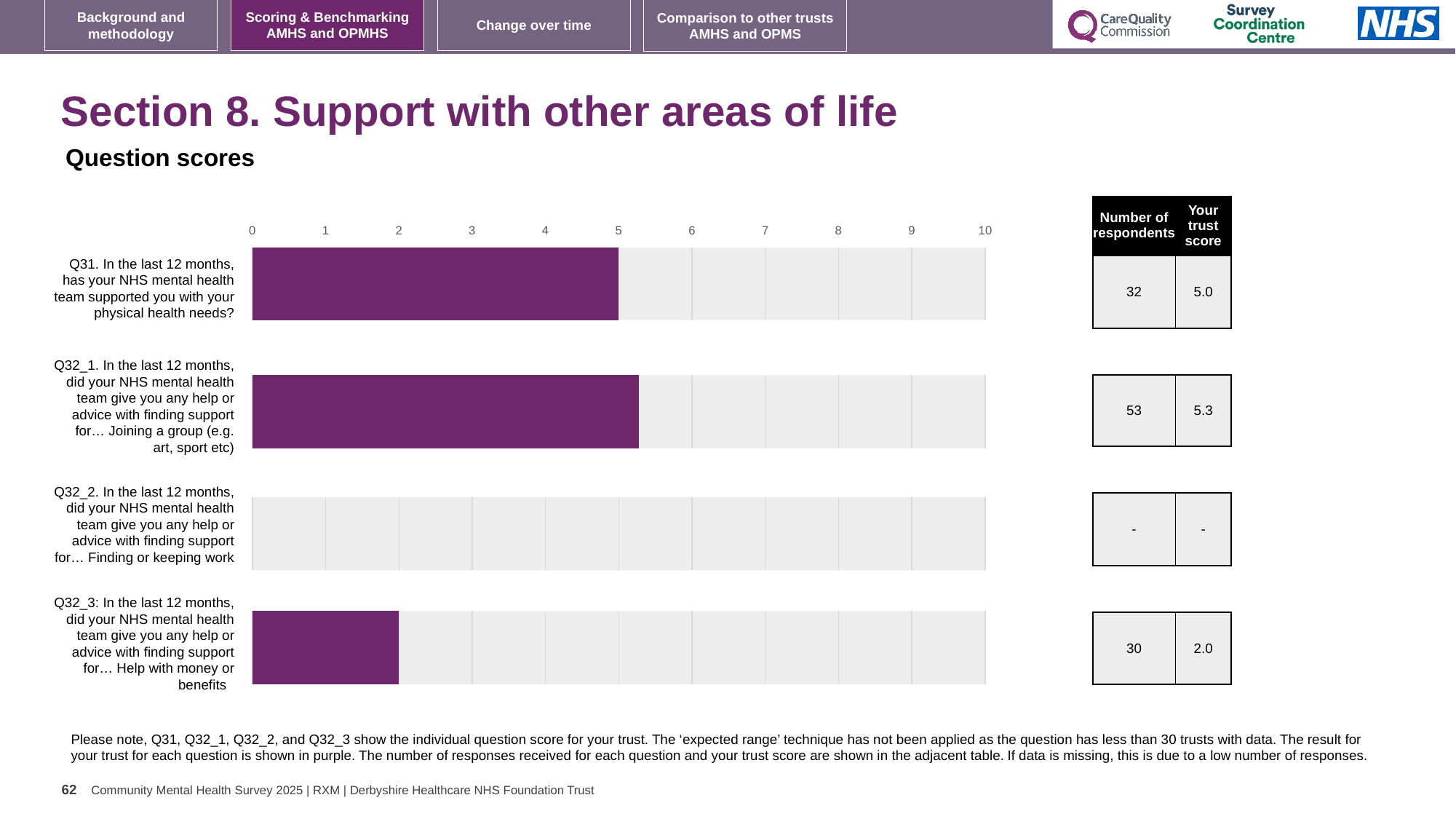
What type of chart is shown on the slide? Bar chart What is the difference between the trust scores for Q32_1 and Q32_3? 3.3 What is the trust score for Q32_1 (help with joining a group)? 5.3 What is the trust score for Q32_3 (help with money or benefits)? 2.0 Which question with a plotted bar has the lowest trust score? Q32_3 Is the trust score for Q32_3 greater or less than 3? less How many respondents answered Q32_1? 53 How many respondents answered Q31? 32 What is the trust score for Q31 (support with physical health needs)? 5.0 Which has the higher trust score, Q31 or Q32_3? Q31 Which question has the highest trust score? Q32_1 How many questions are listed on the chart? 4